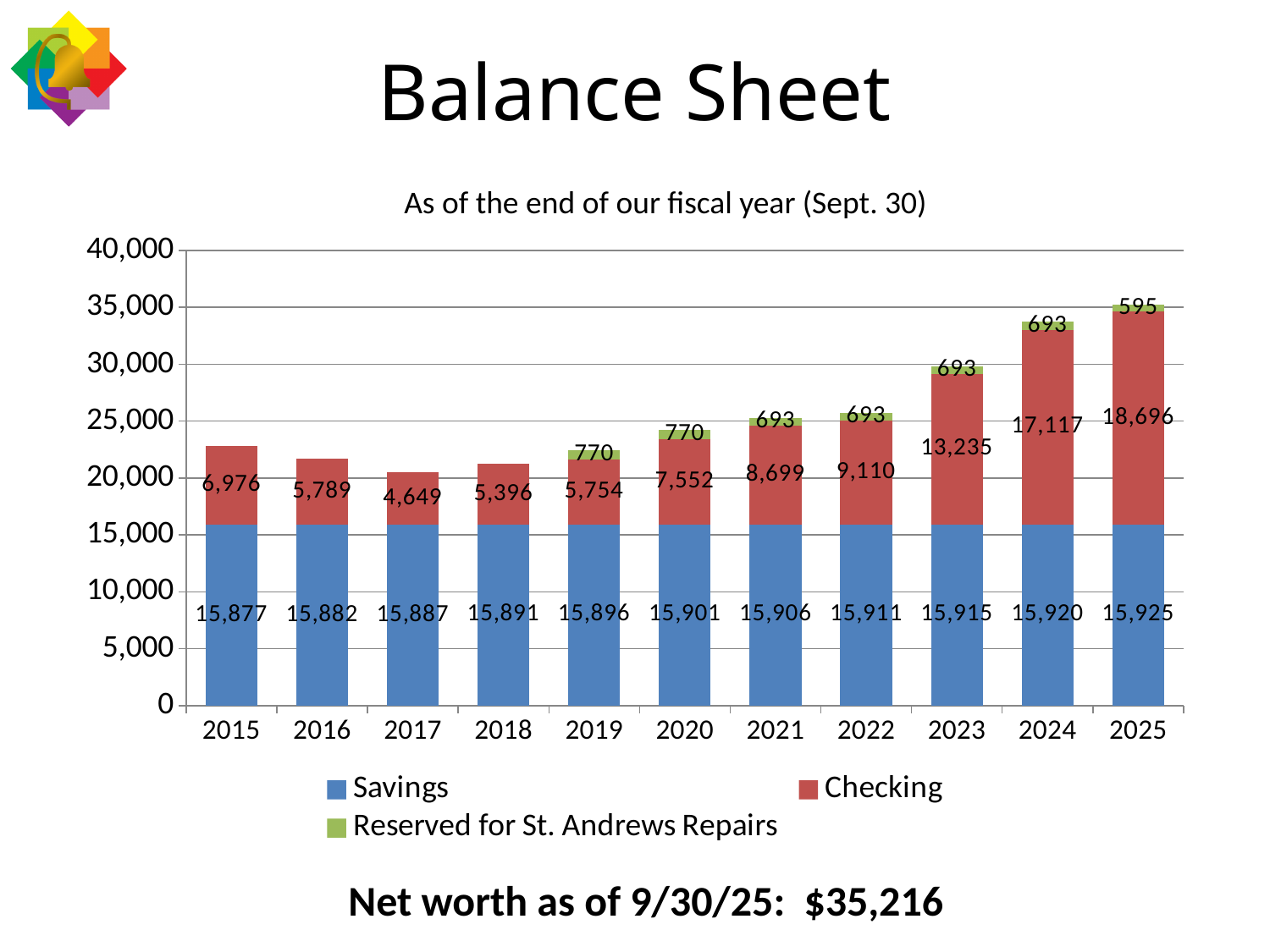
In which year is the Checking value lowest? 2017 How many series does the legend list? 3 What is the Checking value for 2023? 13,235 Is the total of the stacked bar for 2024 greater or less than 30,000? greater What is the Savings value for 2019? 15,896 What is the total of the stacked bar for 2025? 35,216 In which year is the Checking value highest? 2025 What type of chart is shown on the slide? Stacked bar chart Which is larger, the Checking value for 2020 or for 2021? 2021 How many years are shown on the x axis? 11 What is the Reserved for St. Andrews Repairs value for 2025? 595 What is the difference between the Checking values for 2025 and 2024? 1,579